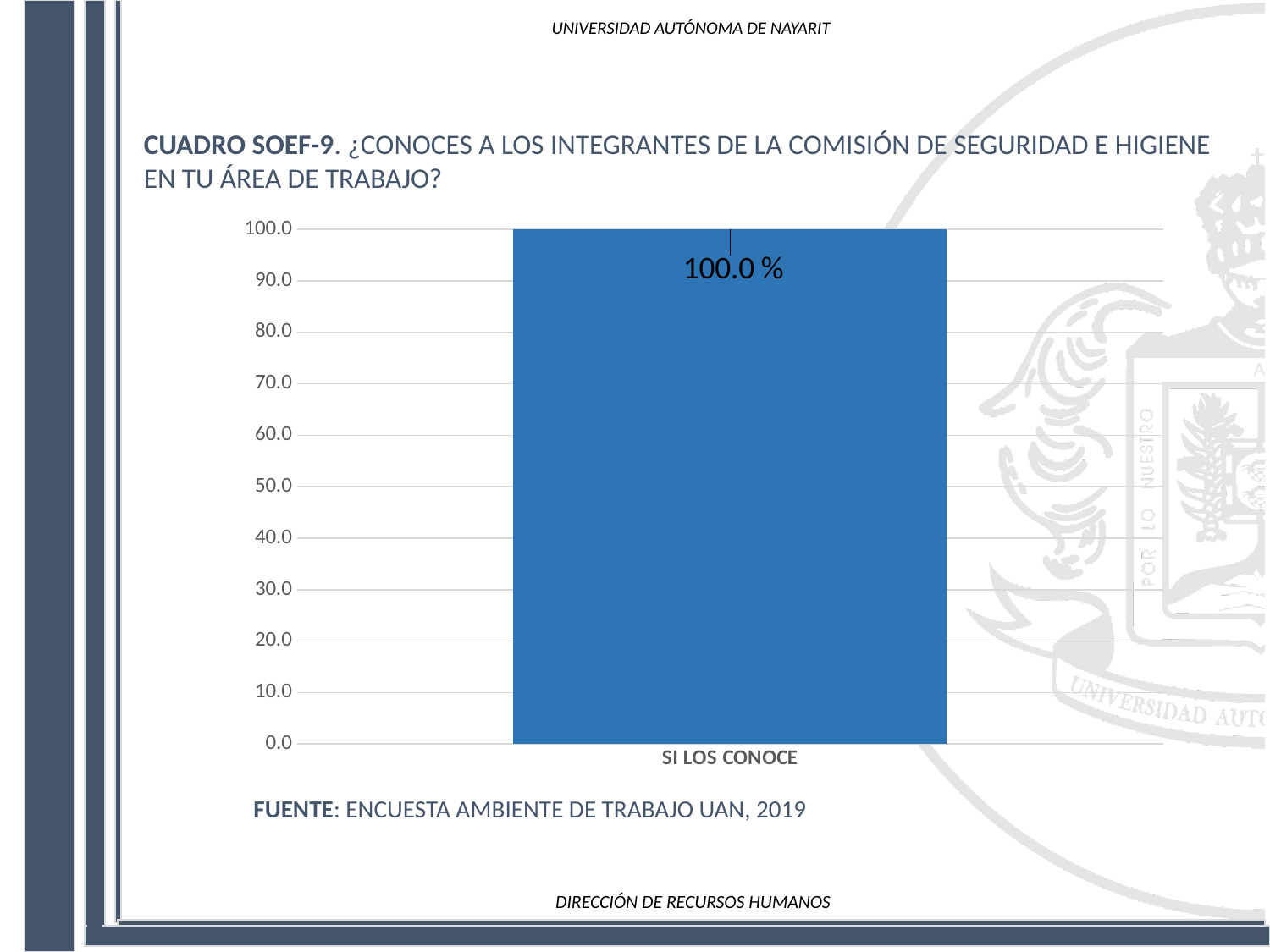
What is the value for SI LOS CONOCE? 100.0 % Is the value for SI LOS CONOCE greater or less than 50.0? greater How many categories are plotted in the chart? 1 What is the highest value shown on the y axis? 100.0 Which category has the highest value in the chart? SI LOS CONOCE What kind of chart is shown on the slide? bar chart What is the label of the only category on the x axis? SI LOS CONOCE